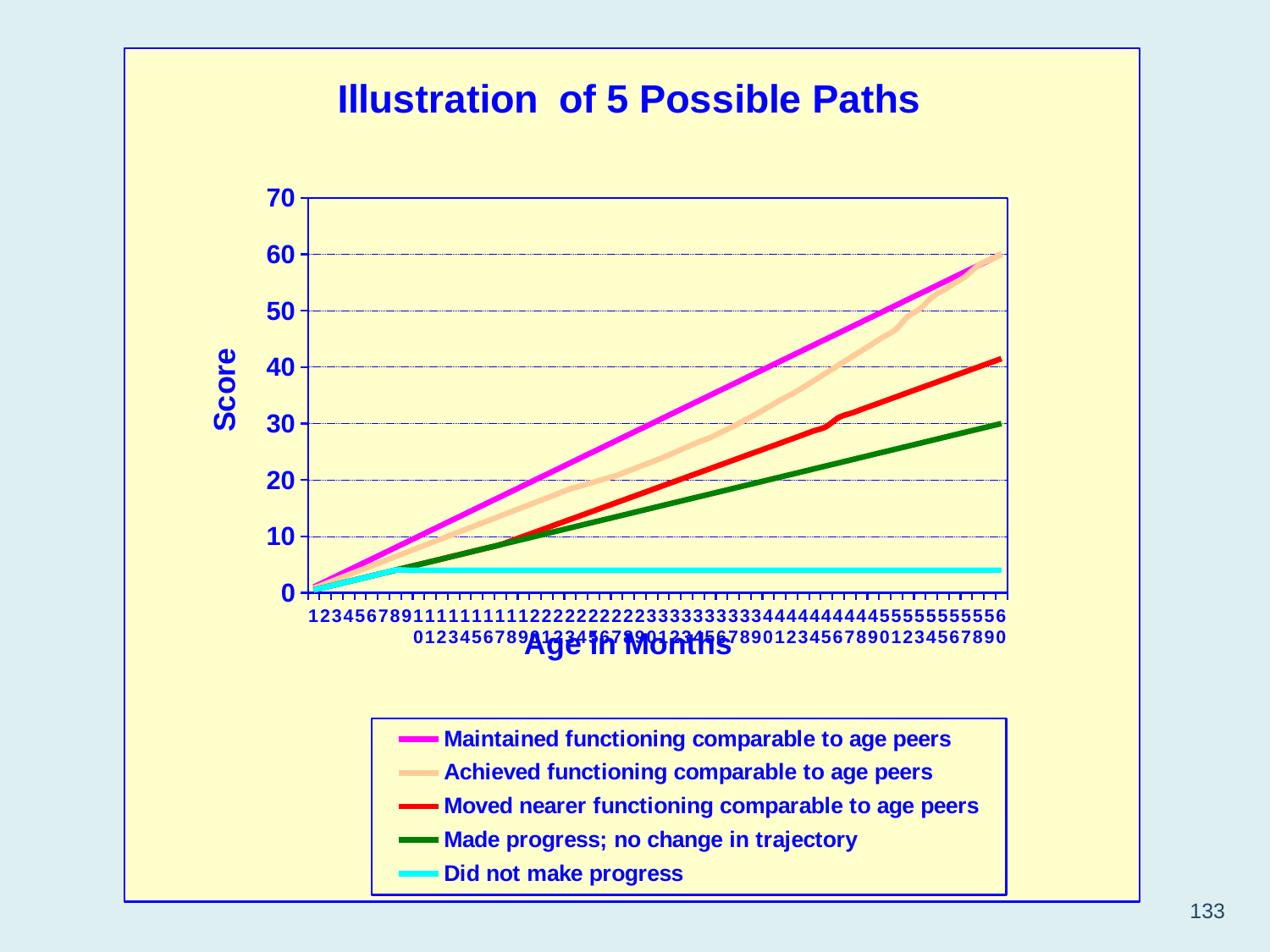
How many series does the legend list? 5 Which series has the lowest score at 60 months? Did not make progress Does the 'Did not make progress' line rise, fall, or stay flat across the age range? stay flat Is the value of the 'Did not make progress' line at 60 months greater or less than 10? less Is the final value of the 'Achieved functioning comparable to age peers' line greater or less than 50? greater At 60 months, which is higher: the 'Moved nearer functioning comparable to age peers' line or the 'Made progress; no change in trajectory' line? Moved nearer functioning comparable to age peers What is the label of the y axis? Score Is the final value of the 'Made progress; no change in trajectory' line greater or less than 20? greater What is the title of the chart? Illustration of 5 Possible Paths Does the 'Maintained functioning comparable to age peers' line rise or fall as age in months increases? rise What kind of chart is shown on the slide? line chart